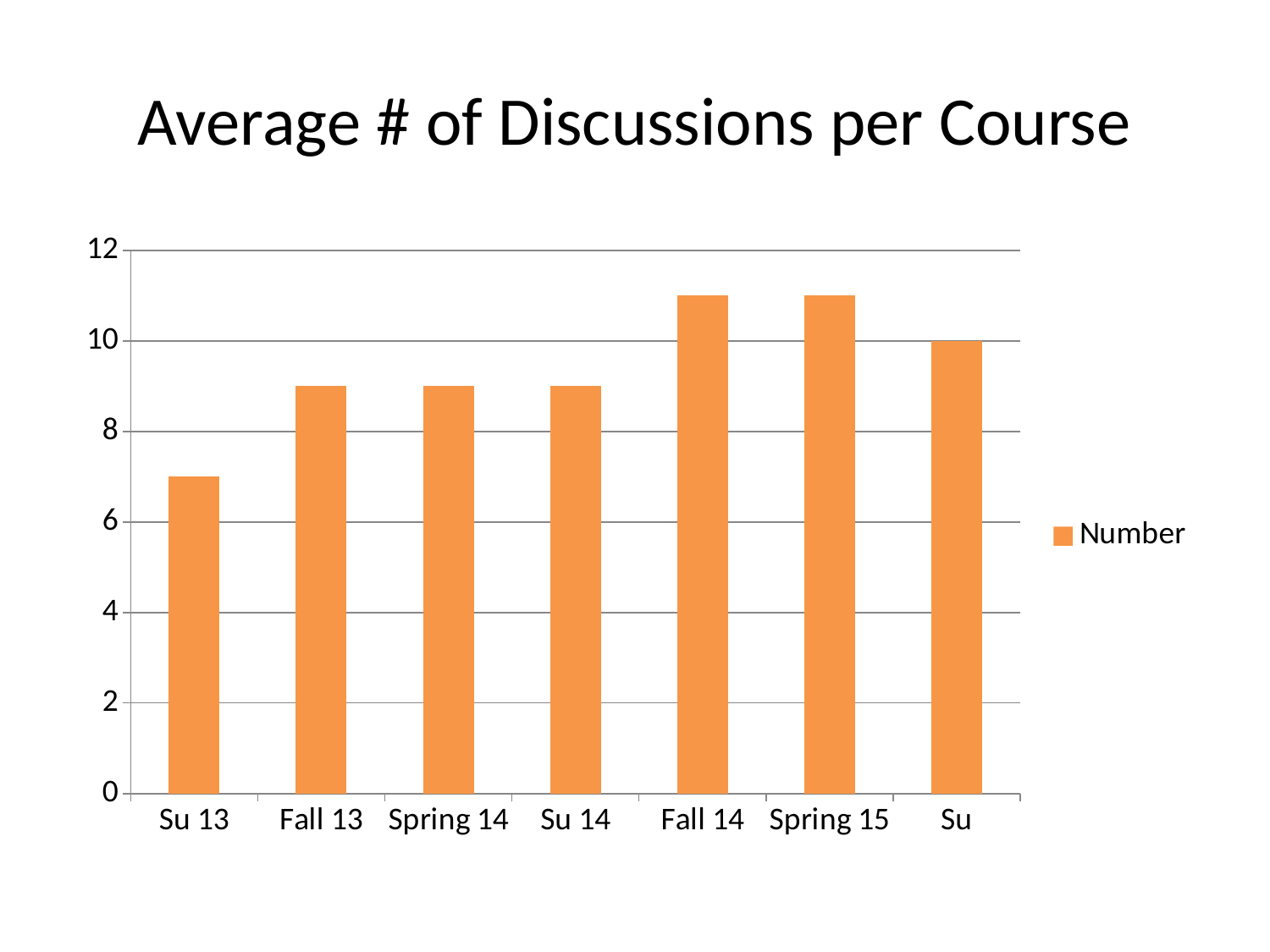
What kind of chart is shown on the slide? bar chart Is the value for Fall 14 greater or less than 10? greater Which is larger, the value for Su 13 or the value for Fall 13? Fall 13 What is the value for the last category, Su? 10 What is the title of the chart? Average # of Discussions per Course Is the value for Fall 13 greater or less than 10? less How many series does the legend list? 1 What is the name of the series in the legend? Number Which is larger, the value for Spring 15 or the value for Su? Spring 15 How many categories are shown on the x axis? 7 Is the value for Su 13 greater or less than 8? less Which category has the lowest value? Su 13